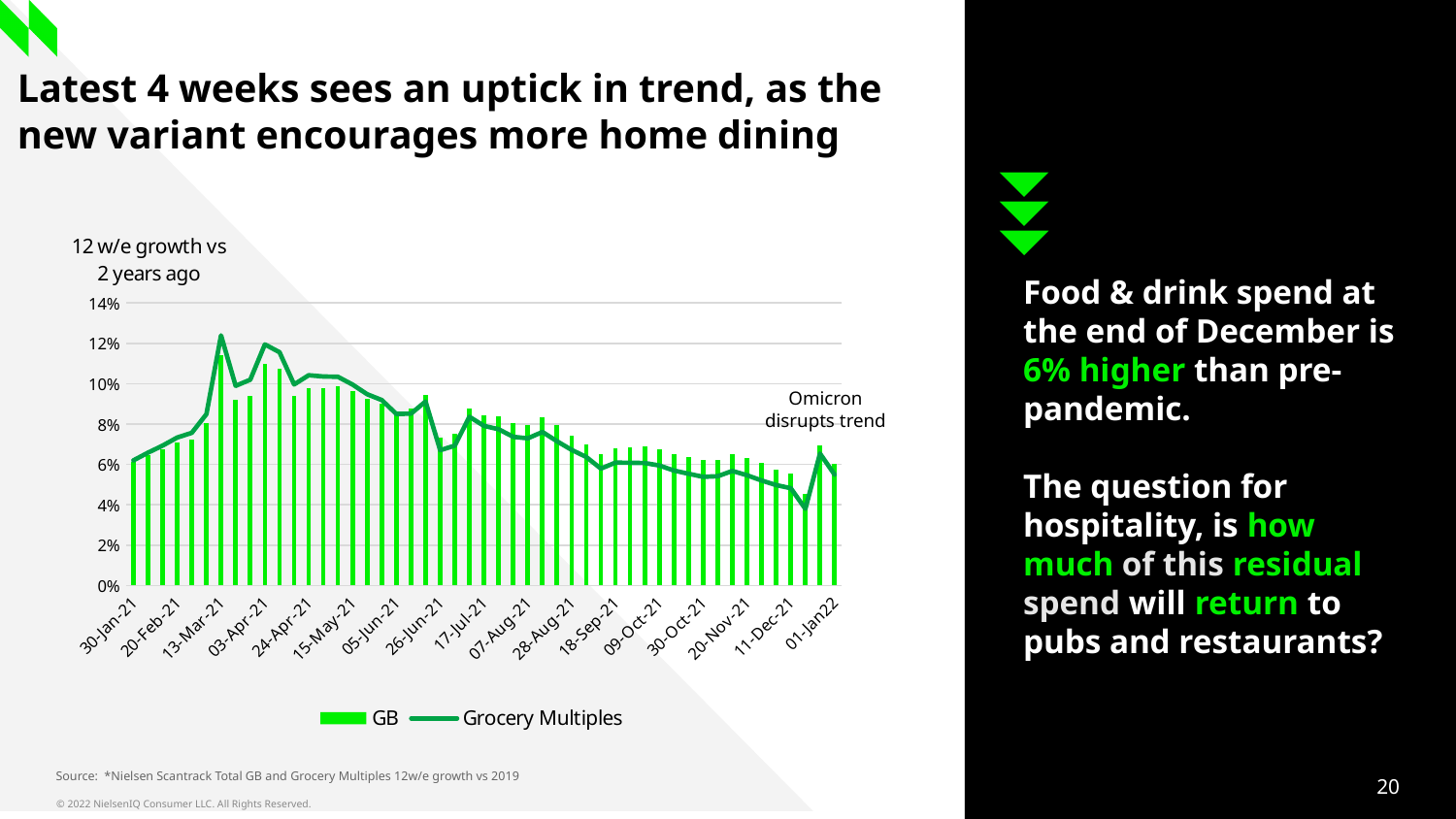
What type of chart is shown on the slide? Combined bar and line chart How many date labels are shown along the x axis? 17 Is the Grocery Multiples value at 13-Mar-21 greater or less than 10%? greater At which date label does the Grocery Multiples line reach its highest point? 13-Mar-21 Does the Grocery Multiples line generally rise or fall between 03-Apr-21 and 11-Dec-21? fall Is the GB bar at 03-Apr-21 greater or less than 10%? greater Which series is plotted as bars and which as a line? GB as bars, Grocery Multiples as a line What is the title shown above the vertical axis of the chart? 12 w/e growth vs 2 years ago Is the Grocery Multiples value at 26-Jun-21 greater or less than 8%? less How many series does the chart legend list? 2